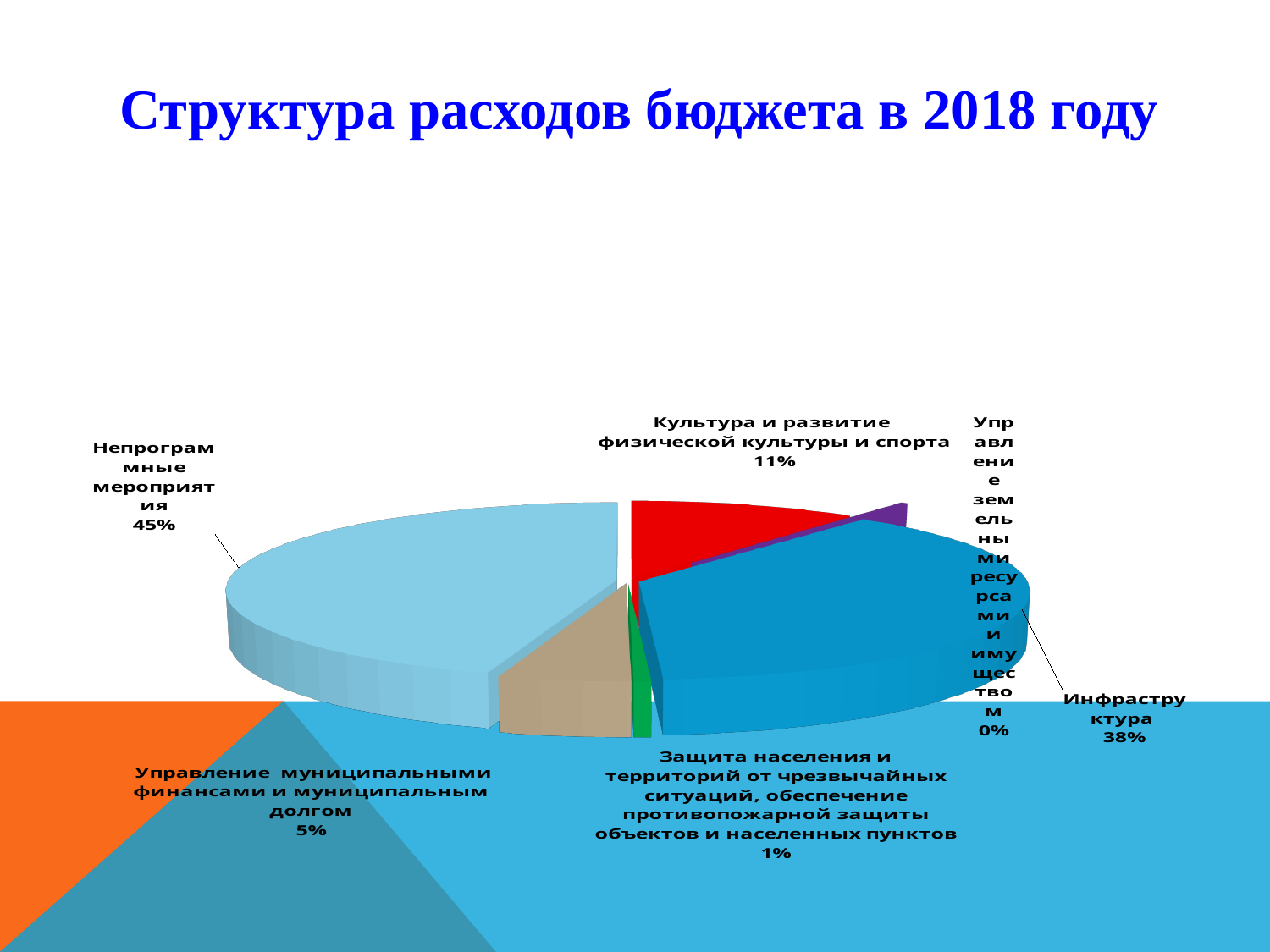
What share is shown for Управление земельными ресурсами и имуществом? 0% How many categories are shown in the pie chart? 6 What share of the budget expenditure goes to Культура и развитие физической культуры и спорта? 11% What share of the budget expenditure goes to Непрограммные мероприятия? 45% What share of the budget expenditure goes to Управление муниципальными финансами и муниципальным долгом? 5% What share of the budget expenditure goes to Инфраструктура? 38% Which category has the largest share of the budget expenditure? Непрограммные мероприятия What is the title of the chart? Структура расходов бюджета в 2018 году What type of chart is shown on the slide? Pie chart Which category has the smallest share of the budget expenditure? Управление земельными ресурсами и имуществом What is the difference in percentage points between Непрограммные мероприятия and Инфраструктура? 7 percentage points What share is shown for Защита населения и территорий от чрезвычайных ситуаций, обеспечение противопожарной защиты объектов и населенных пунктов? 1%